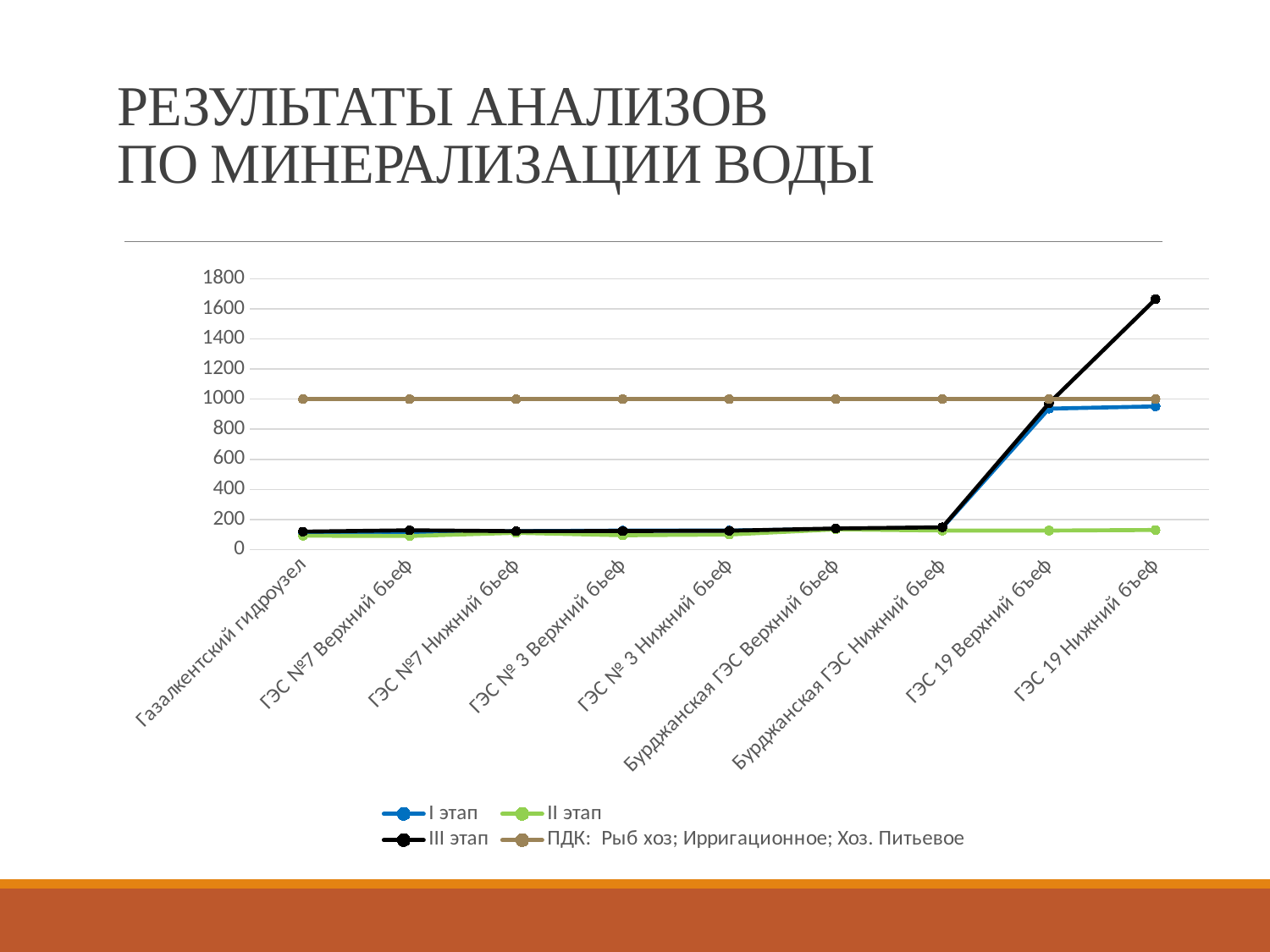
For the series III этап, which category has the highest value? ГЭС 19 Нижний бъеф Which series is drawn in the brown/tan colour in the chart? ПДК: Рыб хоз; Ирригационное; Хоз. Питьевое Is the value of I этап at ГЭС 19 Нижний бъеф greater or less than 800? greater What is the title of the slide containing the chart? РЕЗУЛЬТАТЫ АНАЛИЗОВ ПО МИНЕРАЛИЗАЦИИ ВОДЫ What constant value does the series ПДК: Рыб хоз; Ирригационное; Хоз. Питьевое hold across all categories? 1000 What kind of chart is shown on the slide? line chart At ГЭС 19 Нижний бъеф, which series has the larger value: III этап or II этап? III этап Is the value of II этап at ГЭС 19 Верхний бьеф greater or less than 200? less Does the series III этап rise or fall overall from the first category to the last category along the x axis? rise Is the value of III этап at ГЭС 19 Нижний бъеф greater or less than 1400? greater How many series does the chart legend list? 4 How many categories are shown along the x axis of the chart? 9